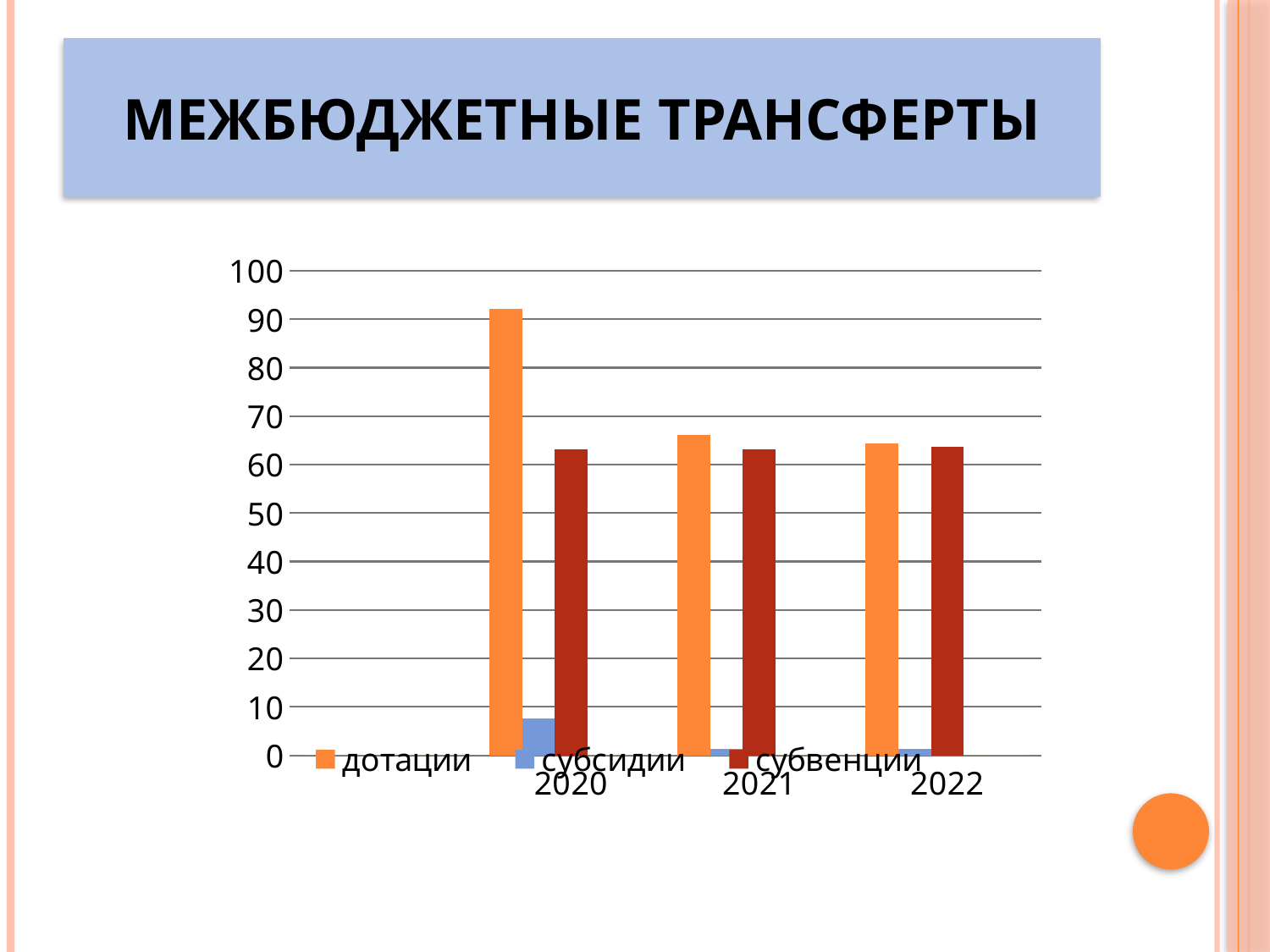
Which is larger in 2020: дотации or субвенции? дотации In which year is the value for субсидии the highest? 2020 What kind of chart is shown on the slide? bar chart Do the values for дотации rise or fall from 2020 to 2022? fall What is the title of the slide containing the chart? МЕЖБЮДЖЕТНЫЕ ТРАНСФЕРТЫ How many years are shown on the x axis of the chart? 3 Which series is shown in orange in the chart? дотации Is the value for дотации in 2020 greater or less than 90? greater How many series does the chart legend list? 3 Is the value for субвенции in 2021 greater or less than 70? less Is the value for субсидии in 2020 greater or less than 10? less In which year is the value for дотации the highest? 2020